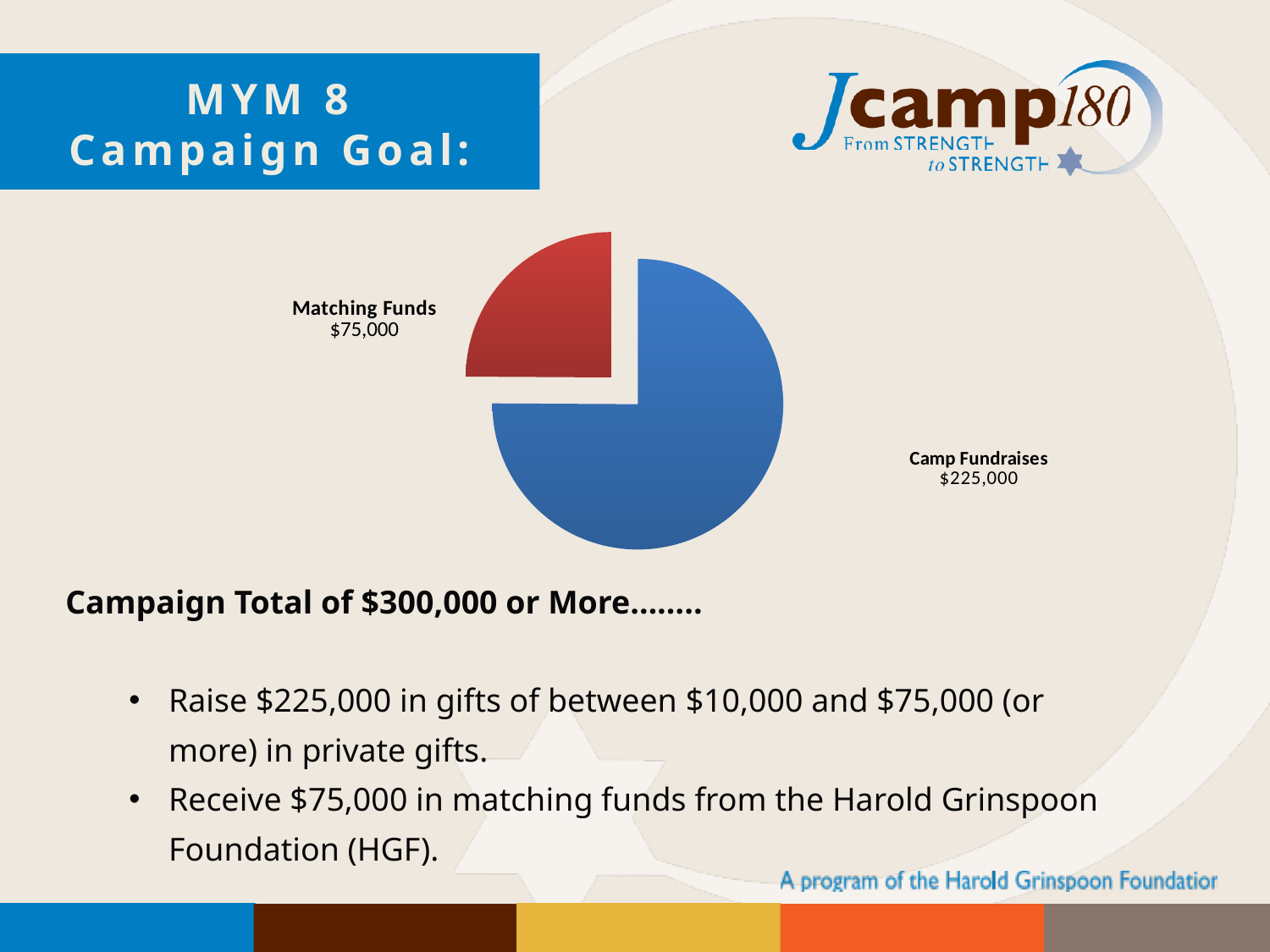
What kind of chart is shown on the slide? pie chart Which is larger, Matching Funds or Camp Fundraises? Camp Fundraises How many slices does the pie chart have? 2 What is the value for Matching Funds? $75,000 What is the total of the two slices in the pie chart? $300,000 What share of the pie does Camp Fundraises represent? 75% What colour is the Matching Funds slice? red What is the value for Camp Fundraises? $225,000 Which slice of the pie is the largest? Camp Fundraises What share of the pie does Matching Funds represent? 25% Which slice of the pie is the smallest? Matching Funds What is the difference between Camp Fundraises and Matching Funds? $150,000